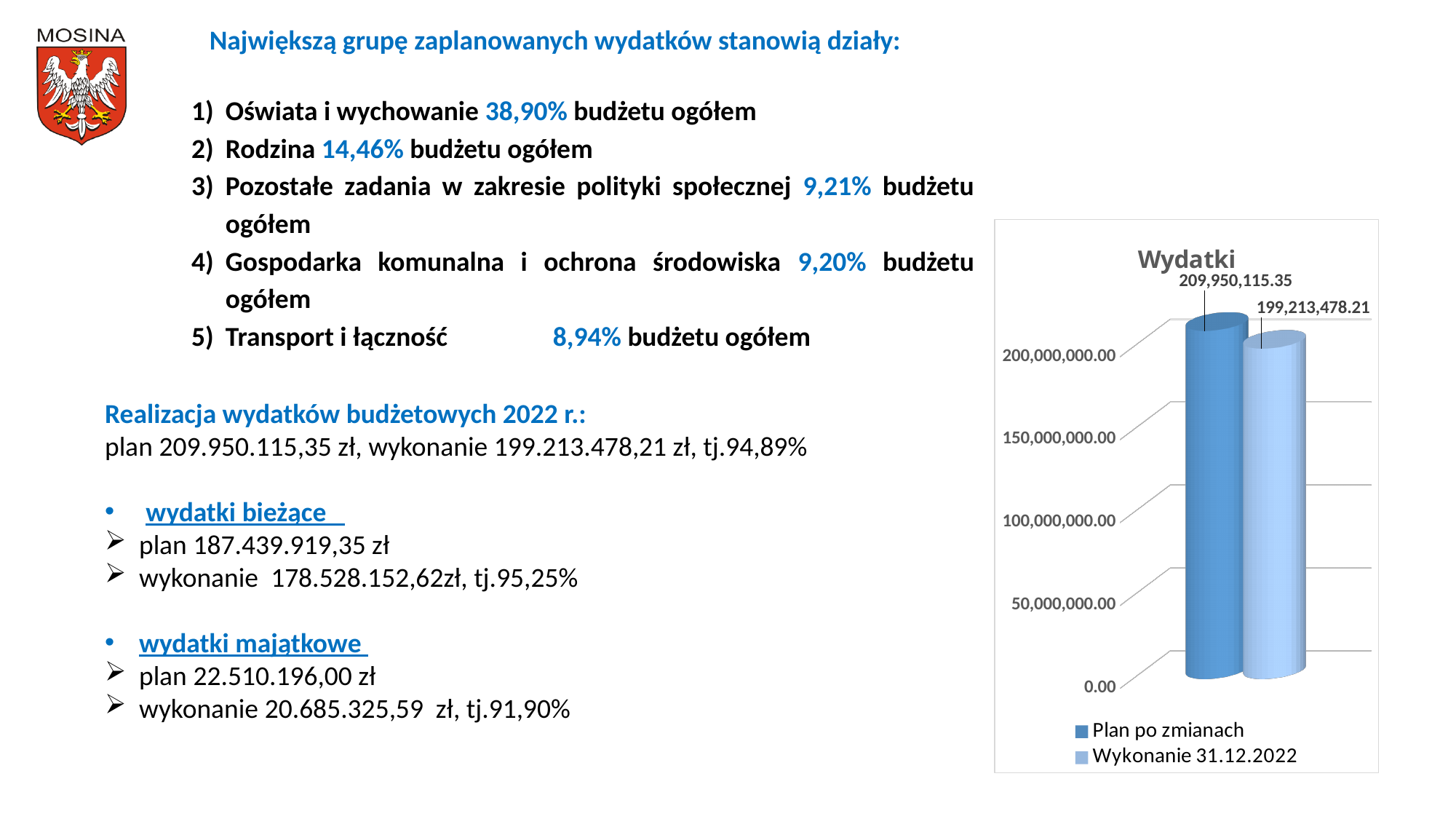
Is the value for Wykonanie 31.12.2022 greater or less than 150,000,000.00? greater Which series has the lower value in the Wydatki chart? Wykonanie 31.12.2022 How many series does the legend of the Wydatki chart list? 2 Which legend entry is shown in the lighter blue colour? Wykonanie 31.12.2022 Is the value for Plan po zmianach greater or less than 200,000,000.00? greater What is the value for Plan po zmianach in the Wydatki chart? 209,950,115.35 What is the difference between Plan po zmianach and Wykonanie 31.12.2022 in the Wydatki chart? 10,736,637.14 Which series has the higher value in the Wydatki chart? Plan po zmianach What is the value for Wykonanie 31.12.2022 in the Wydatki chart? 199,213,478.21 What is the title of the chart on the slide? Wydatki Is the value for Plan po zmianach larger or smaller than the value for Wykonanie 31.12.2022? larger What kind of chart is shown on the slide? bar chart